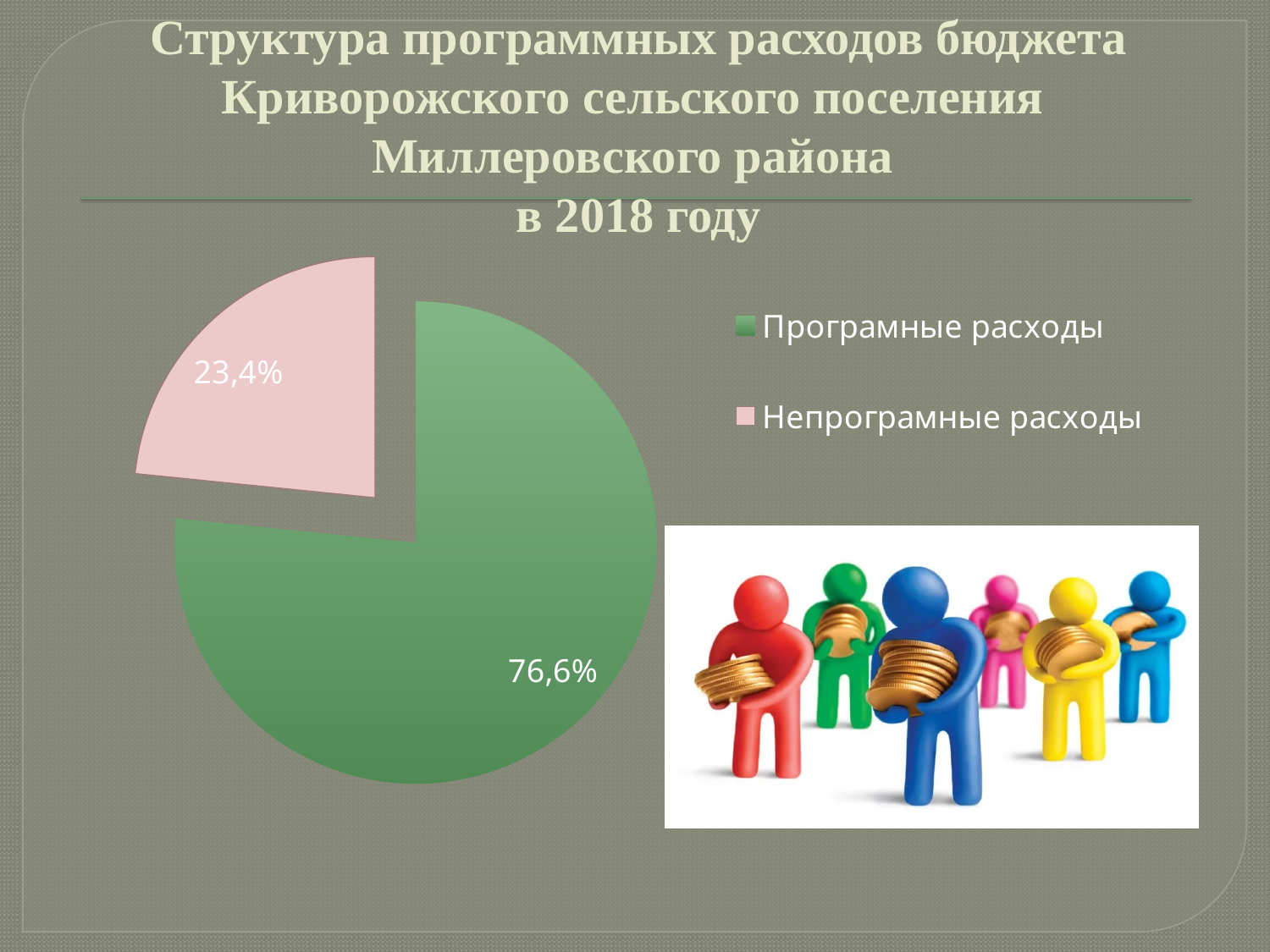
Which slice of the pie is the smallest? Непрограмные расходы What share of the pie is labelled for Програмные расходы? 76,6% What share of the pie is labelled for Непрограмные расходы? 23,4% How many slices does the pie chart have? 2 What colour is the slice for Програмные расходы? green What is the difference between the shares of Програмные расходы and Непрограмные расходы? 53,2% Which slice of the pie is the largest? Програмные расходы What colour is the slice for Непрограмные расходы? pink What kind of chart is shown on the slide? pie chart How many entries does the legend list? 2 Which is larger: the share of Програмные расходы or the share of Непрограмные расходы? Програмные расходы